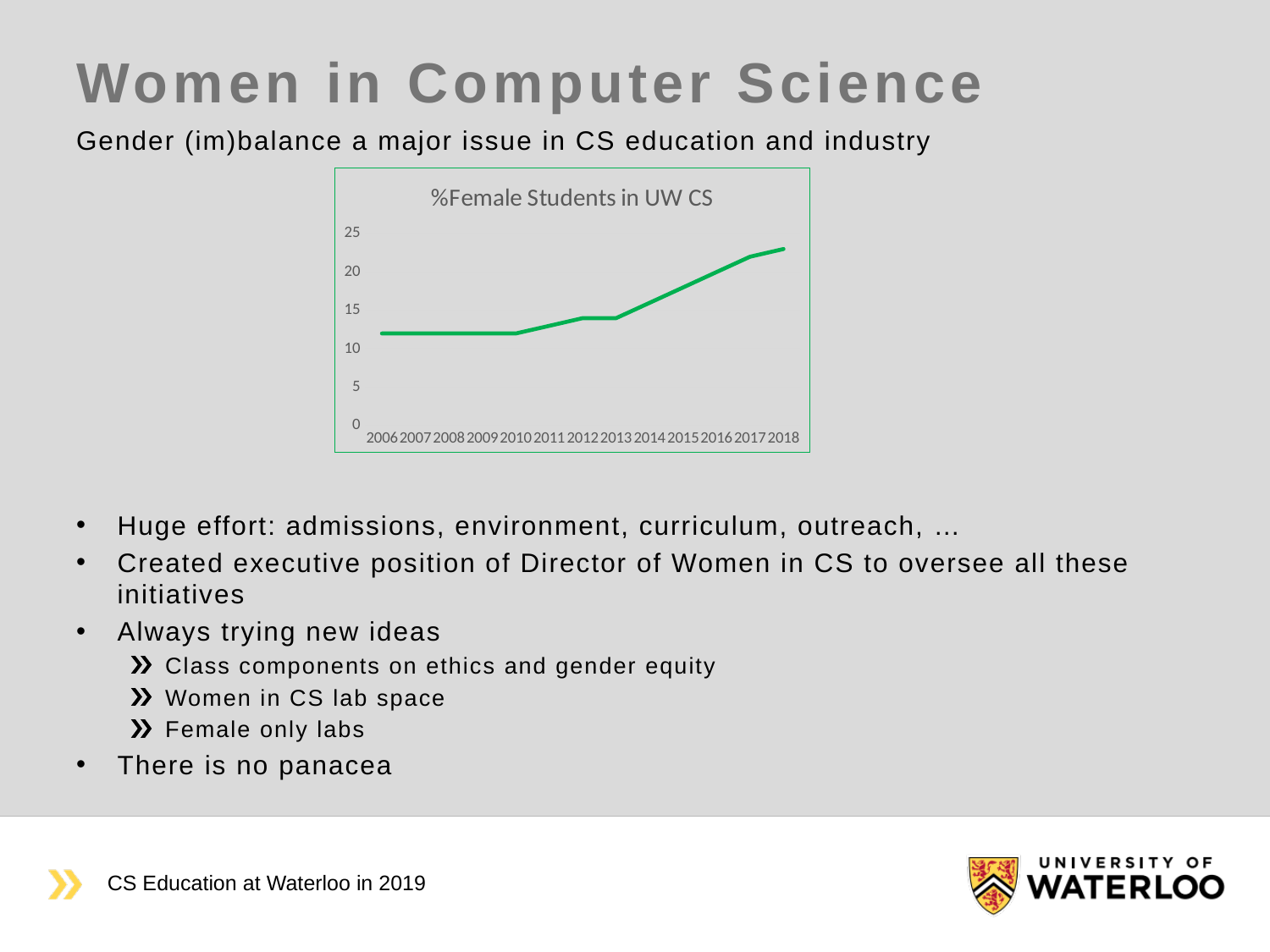
Which year has the larger value, 2012 or 2016? 2016 What is the highest value shown on the y axis of the chart? 25 Is the value for 2013 greater or less than 15? less What is the title of the chart? %Female Students in UW CS Is the value for 2015 greater or less than 15? greater Is the value for 2006 greater or less than 10? greater What kind of chart is shown on the slide? line chart Which year has the highest value in the chart? 2018 Do the values in the chart generally rise or fall from 2006 to 2018? rise How many years are plotted on the x axis of the chart? 13